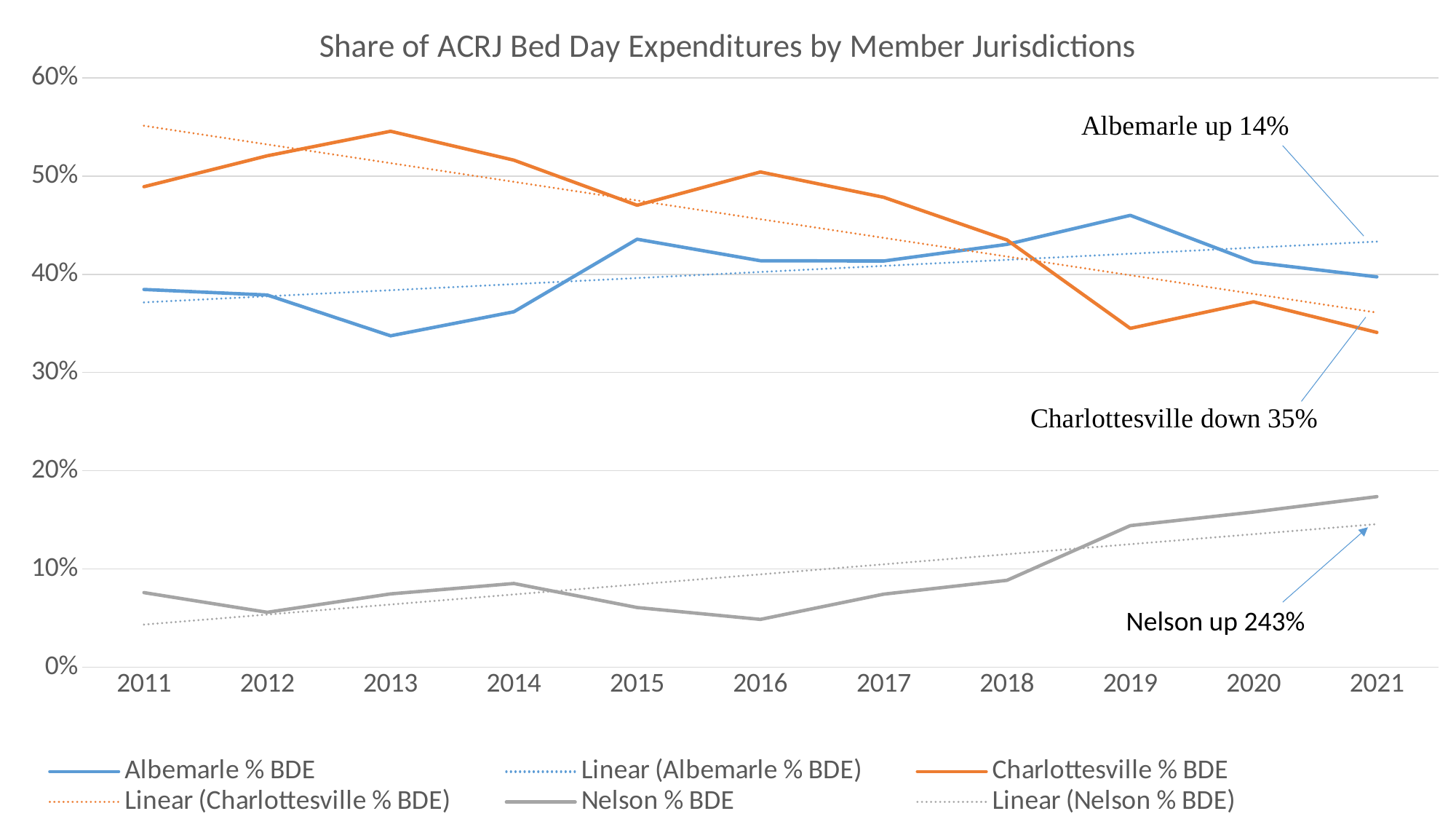
What is the title of the chart? Share of ACRJ Bed Day Expenditures by Member Jurisdictions Is the value for Nelson % BDE in 2021 greater or less than 20%? less How many years are shown on the x axis of the chart? 11 Is the value for Charlottesville % BDE in 2013 greater or less than 50%? greater In which year is Charlottesville % BDE at its highest? 2013 Is the value for Albemarle % BDE in 2013 greater or less than 40%? less Does Nelson % BDE rise or fall from 2016 to 2021? rise In 2011, which is larger: Charlottesville % BDE or Albemarle % BDE? Charlottesville % BDE What kind of chart is shown on the slide? line chart How many entries does the chart's legend list? 6 In 2021, which is larger: Albemarle % BDE or Charlottesville % BDE? Albemarle % BDE In which year is Nelson % BDE at its lowest? 2016